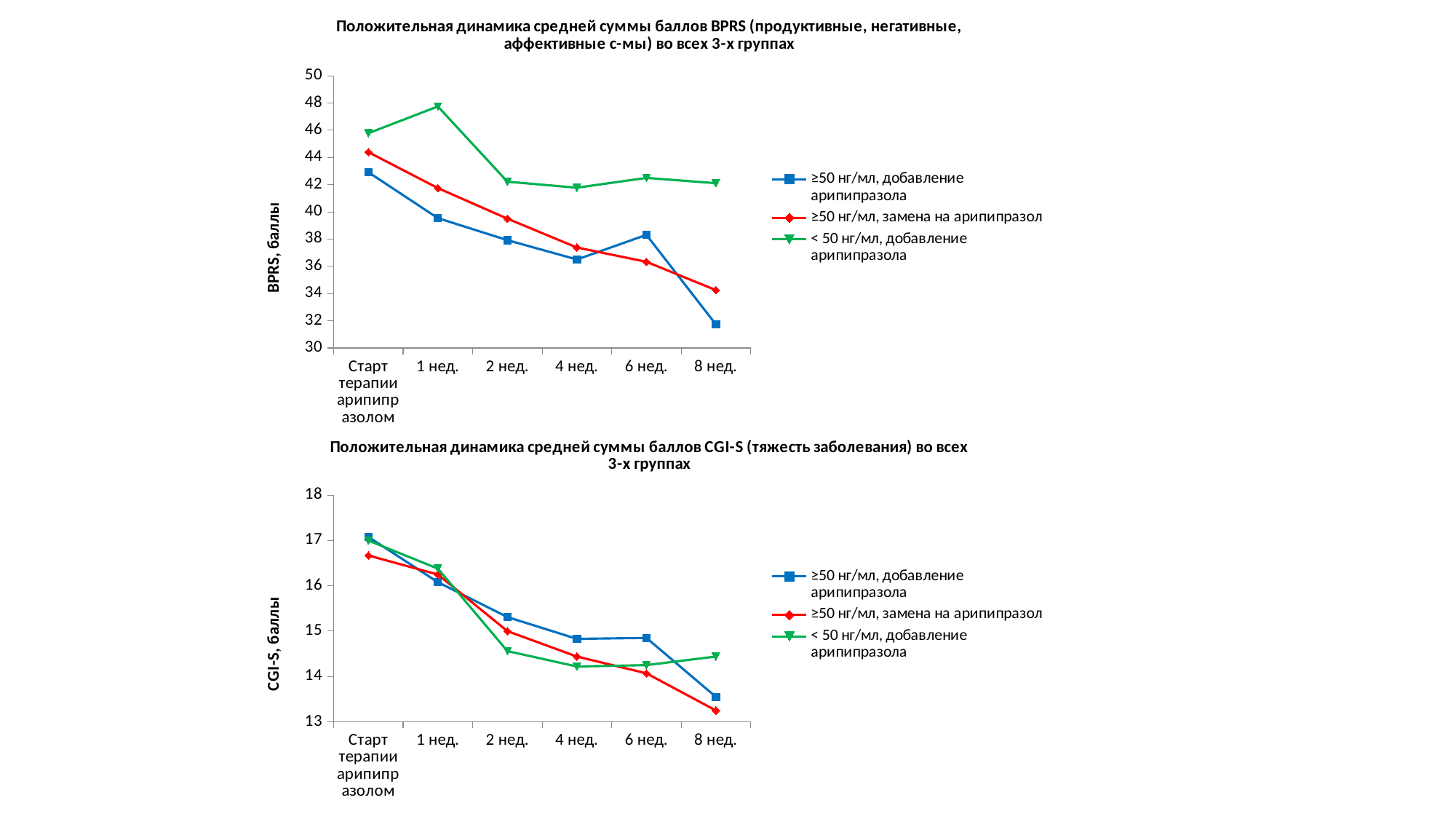
In the top chart (BPRS), which series has the highest value at 8 нед.? < 50 нг/мл, добавление арипипразола How many series does the legend of the top chart (BPRS) list? 3 In the top chart (BPRS), is the value for < 50 нг/мл, добавление арипипразола at 8 нед. greater or less than 40? greater In the top chart (BPRS), does the ≥50 нг/мл, замена на арипипразол series rise or fall from the start of therapy to 8 нед.? fall In the top chart (BPRS), which series has the lowest value at 8 нед.? ≥50 нг/мл, добавление арипипразола How many time points are plotted along the x axis of the bottom chart (CGI-S)? 6 What is the y-axis label of the bottom chart? CGI-S, баллы In the bottom chart (CGI-S), which series has the highest value at 8 нед.? < 50 нг/мл, добавление арипипразола What kind of chart is the top chart (BPRS)? line chart In the bottom chart (CGI-S), which is larger at 2 нед.: ≥50 нг/мл, добавление арипипразола or < 50 нг/мл, добавление арипипразола? ≥50 нг/мл, добавление арипипразола In the top chart (BPRS), is the value for ≥50 нг/мл, добавление арипипразола at 8 нед. greater or less than 34? less In the bottom chart (CGI-S), is the value for ≥50 нг/мл, замена на арипипразол at 8 нед. greater or less than 14? less